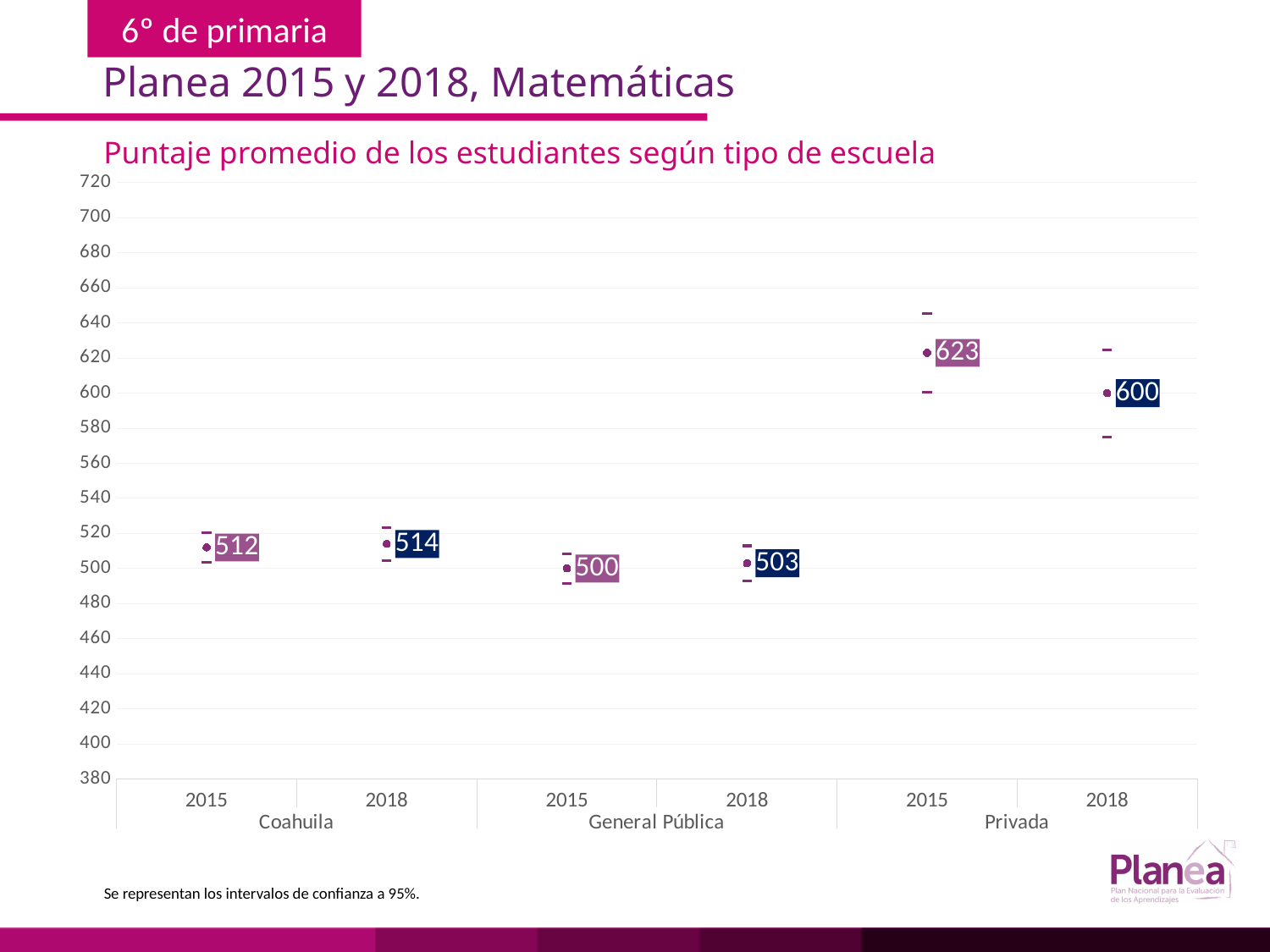
What is the average score for Privada in 2018? 600 What is the average score for Coahuila in 2018? 514 What is the average score for Coahuila in 2015? 512 Which is larger, the Coahuila 2018 score or the General Pública 2018 score? Coahuila 2018 Which school type and year has the highest average score? Privada 2015 Which school type and year has the lowest average score? General Pública 2015 What is the title of the chart? Puntaje promedio de los estudiantes según tipo de escuela What is the average score for General Pública in 2015? 500 What is the difference between the Privada scores in 2015 and 2018? 23 Did the Privada average score rise or fall from 2015 to 2018? Fall What is the difference between the General Pública scores in 2018 and 2015? 3 How many data points are plotted on the chart? 6